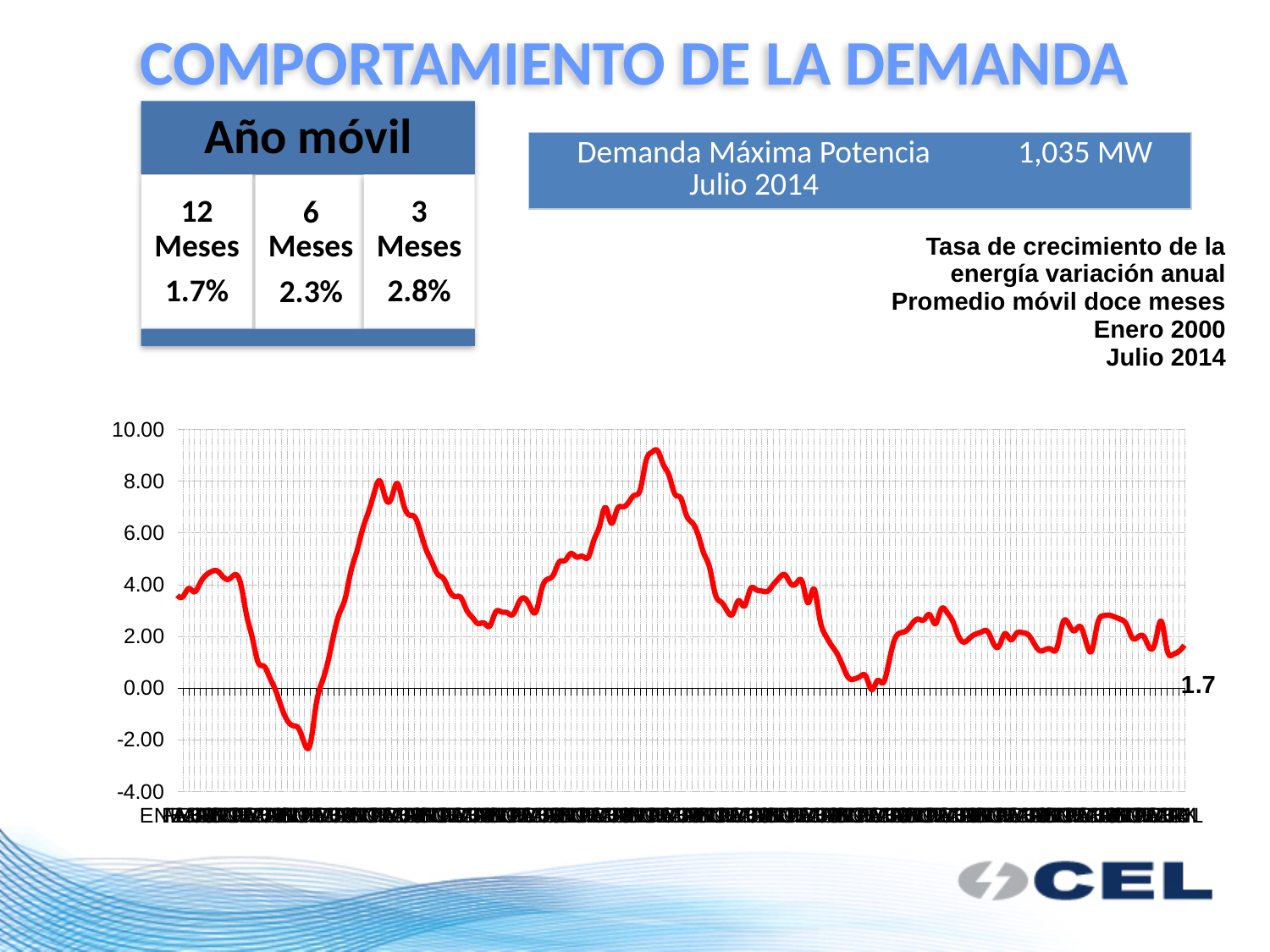
What is the highest value shown on the vertical axis? 10.00 Is the lowest point of the line greater or less than -1.00? less How many lines are plotted on the chart? 1 What kind of chart is shown on the slide? line chart Is the final labelled value of the line greater or less than 2.00? less What is the lowest value shown on the vertical axis? -4.00 Does the line end higher or lower than where it starts? lower Is the highest point of the line greater or less than 8.00? greater What is the data label shown at the right end of the line? 1.7